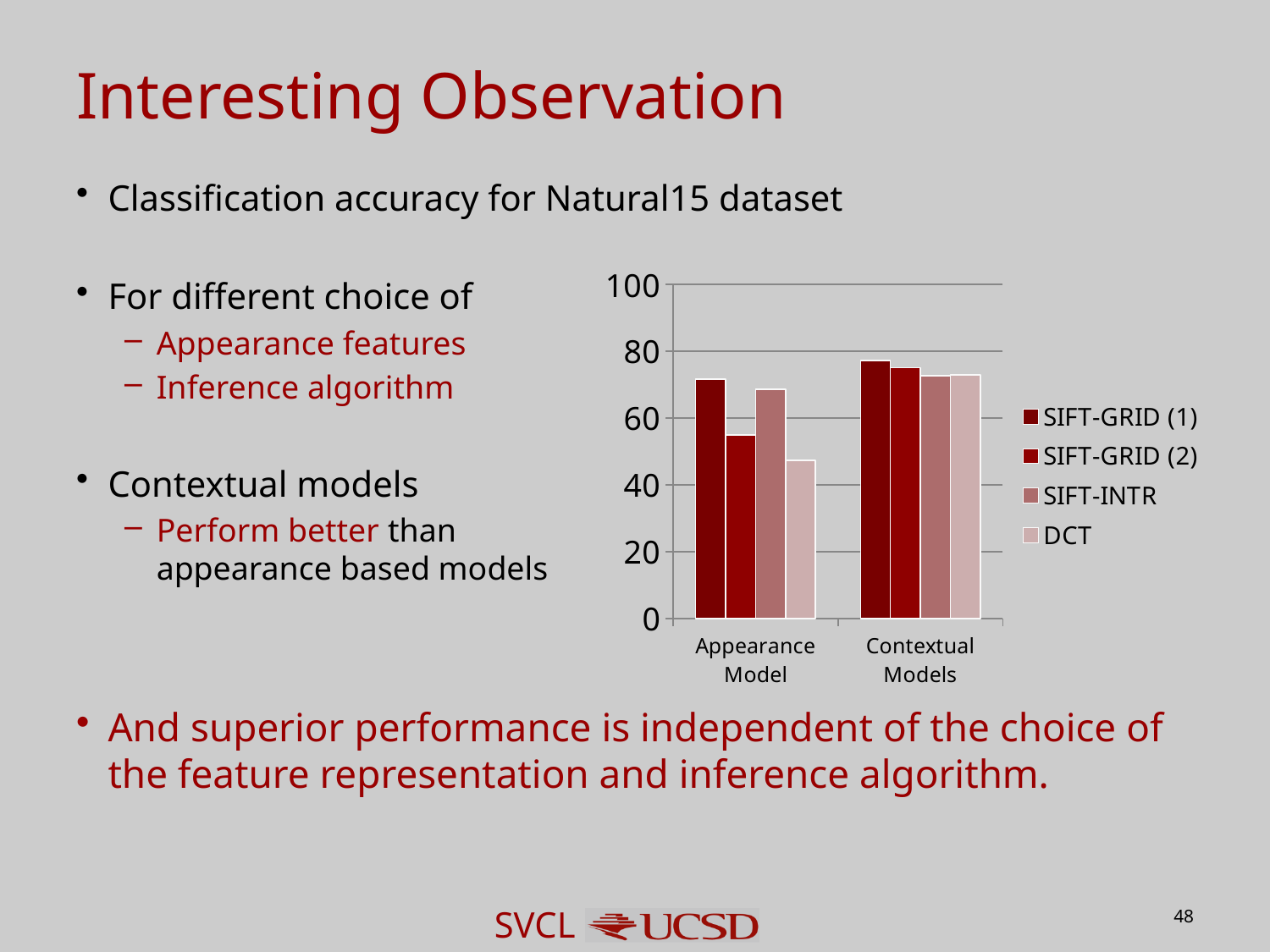
What is the name of the last series listed in the chart's legend? DCT Which is larger: the DCT value for the Appearance Model or the DCT value for Contextual Models? Contextual Models Which series has the lowest value for the Appearance Model category? DCT How many series does the chart's legend list? 4 Is the DCT value for the Appearance Model greater or less than 60? less What kind of chart is shown on the slide? bar chart Is the SIFT-GRID (2) value for the Appearance Model greater or less than 60? less How many categories are shown on the x axis of the chart? 2 Is the SIFT-GRID (1) value for Contextual Models greater or less than 60? greater Which is larger: the SIFT-GRID (2) value for the Appearance Model or the SIFT-INTR value for the Appearance Model? SIFT-INTR Do the values for every series rise or fall from Appearance Model to Contextual Models? rise